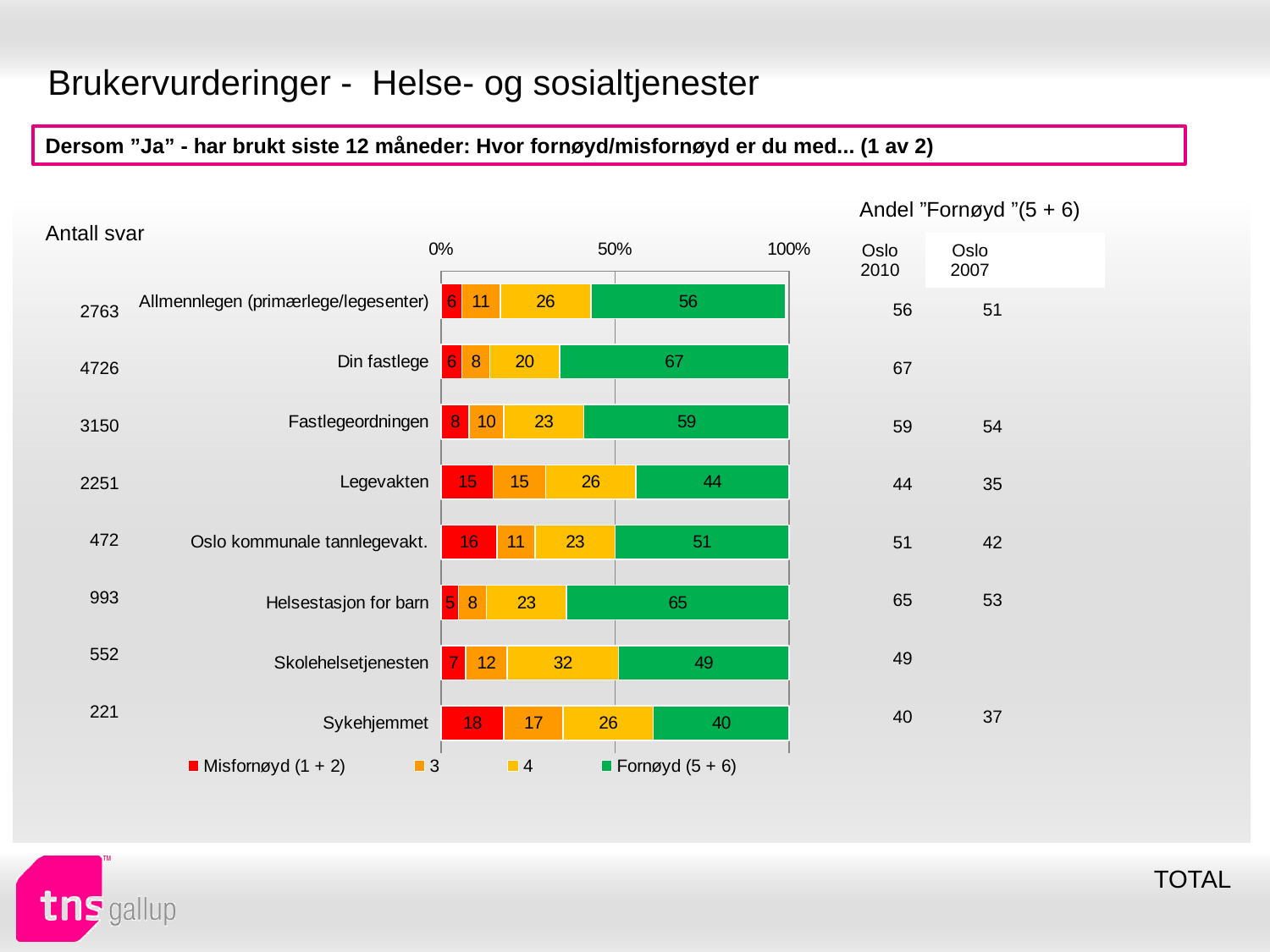
Which has a larger "Misfornøyd (1 + 2)" value, Legevakten or Oslo kommunale tannlegevakt.? Oslo kommunale tannlegevakt. How many categories are shown in the chart? 8 What is the value of the "Fornøyd (5 + 6)" segment for Din fastlege? 67 How many series does the legend list? 4 Which category has the lowest "Fornøyd (5 + 6)" value? Sykehjemmet What is the first legend entry in the chart? Misfornøyd (1 + 2) What is the value of the "Misfornøyd (1 + 2)" segment for Sykehjemmet? 18 What is the value of the "4" segment for Skolehelsetjenesten? 32 What kind of chart is shown on the slide? Stacked bar chart What is the total of the stacked bar for Fastlegeordningen? 100 What is the difference between the "Fornøyd (5 + 6)" values for Helsestasjon for barn and Legevakten? 21 Which category has the highest "Fornøyd (5 + 6)" value? Din fastlege